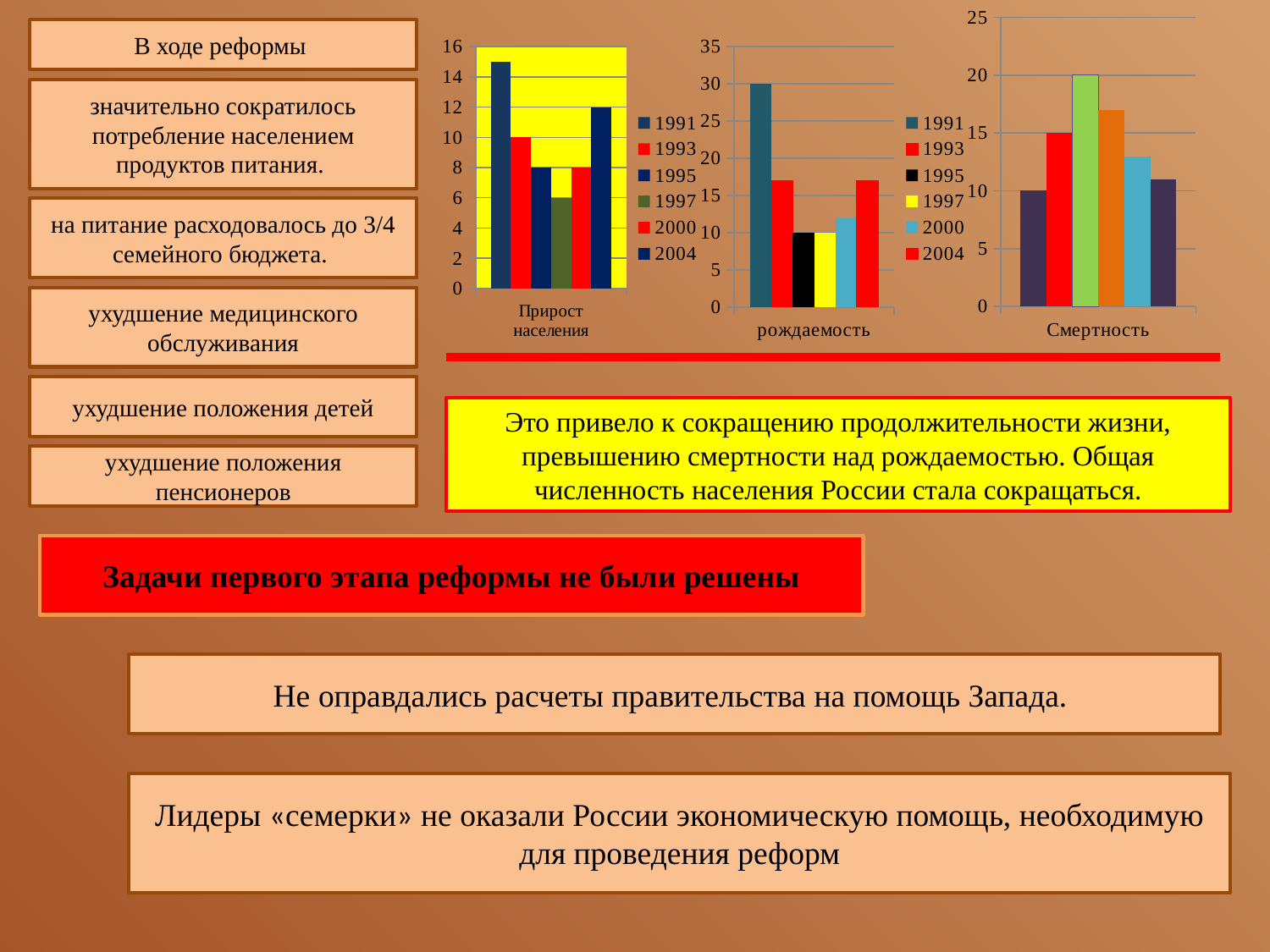
In the 'Прирост населения' chart, which year has the highest value? 1991 In the 'Смертность' chart, is the tallest bar greater or less than 15? greater In the 'рождаемость' chart, is the value for 1993 greater or less than 15? greater What type of chart is the 'Прирост населения' chart? bar chart In the 'рождаемость' chart, is the value for 1991 greater or less than 25? greater In the 'Прирост населения' chart, how many series does the legend list? 6 In the 'рождаемость' chart, which year has the highest value? 1991 In the 'Прирост населения' chart, which year has the lowest value? 1997 How many bars are plotted in the 'Смертность' chart? 6 In the 'Прирост населения' chart, which is larger, the value for 1993 or the value for 2004? 2004 In the 'рождаемость' chart, which is larger, the value for 1991 or the value for 2000? 1991